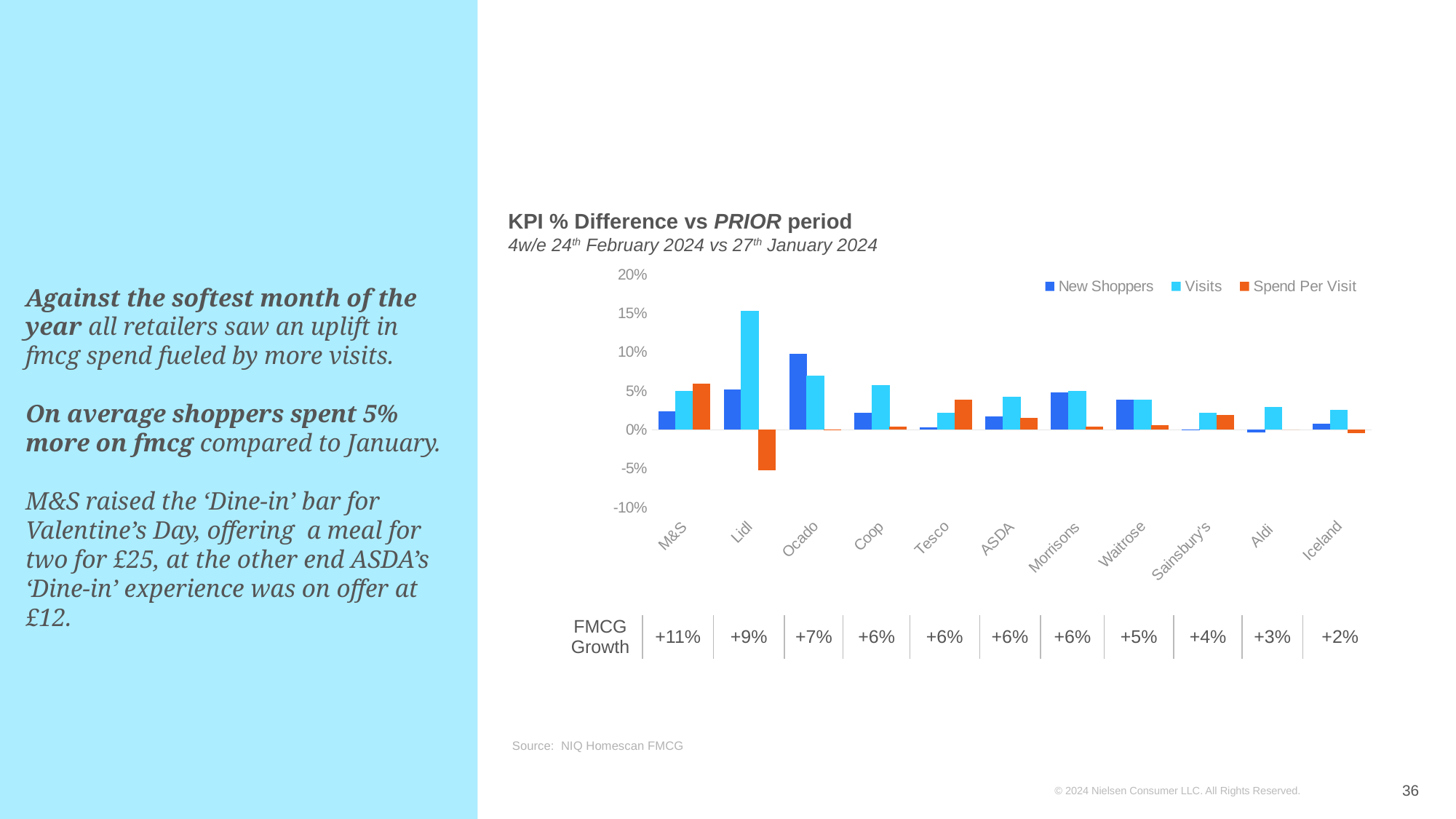
Is the New Shoppers value for Ocado greater or less than 5%? greater How many retailers are shown on the x axis of the chart? 11 What kind of chart is shown on the slide? bar chart Which retailer has the highest Visits value in the chart? Lidl Which series in the legend is shown in orange? Spend Per Visit What is the FMCG Growth figure shown for M&S below the chart? +11% Which retailer has the lowest Spend Per Visit value in the chart? Lidl Is the Spend Per Visit value for Lidl greater or less than 0%? less How many series does the chart legend list? 3 Which is larger for Ocado: New Shoppers or Visits? New Shoppers What is the FMCG Growth figure shown for Iceland below the chart? +2% Is the Visits value for Lidl greater or less than 10%? greater